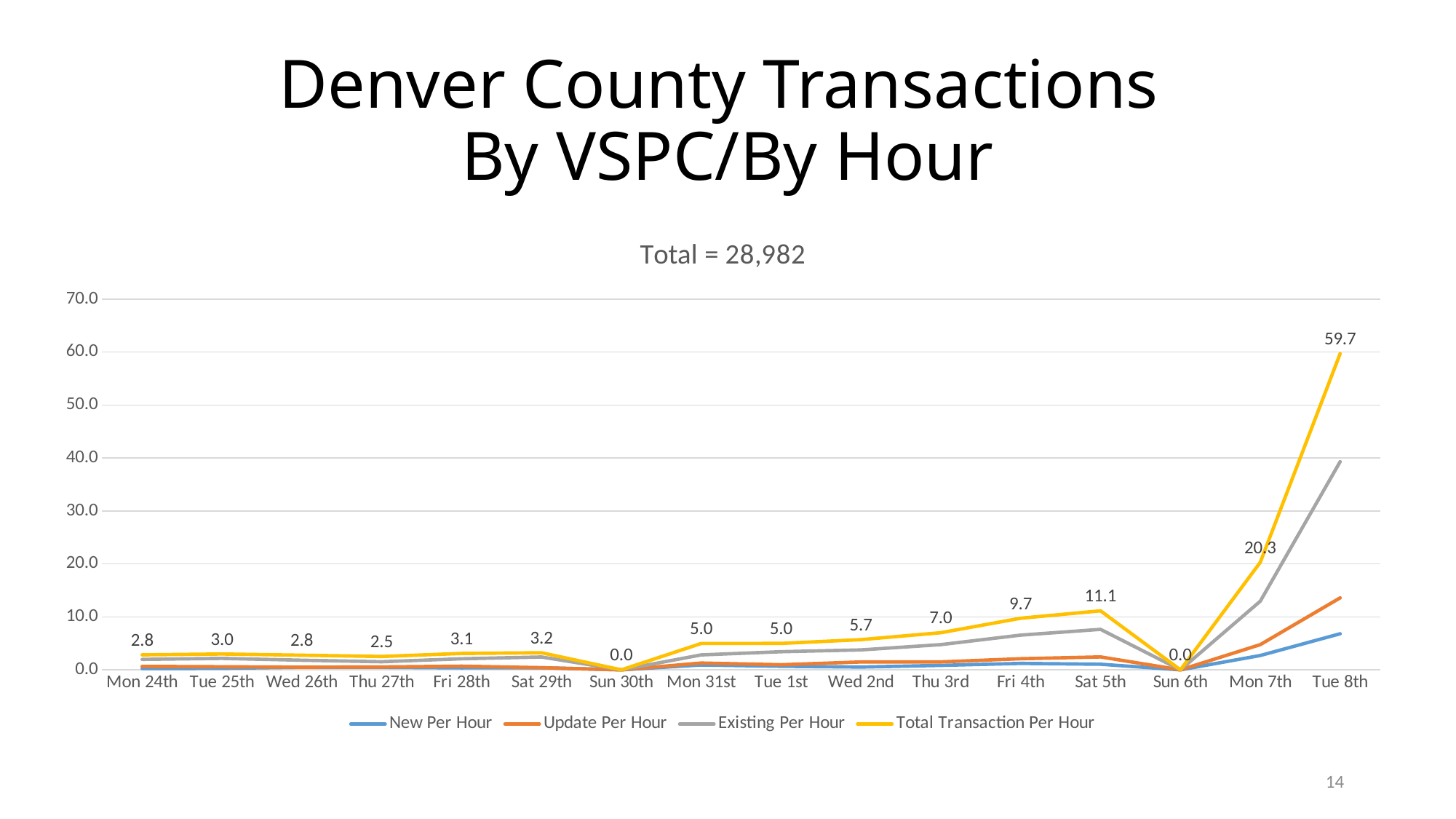
How many series does the legend list? 4 How many dates are shown along the x axis? 16 What is the Total Transaction Per Hour value for Mon 7th? 20.3 What kind of chart is shown on the slide? line chart What is the difference between the Total Transaction Per Hour values for Tue 8th and Mon 7th? 39.4 What is the Total Transaction Per Hour value for Thu 27th? 2.5 Which is larger, the Total Transaction Per Hour value for Fri 4th or for Thu 3rd? Fri 4th Is the Existing Per Hour value for Tue 8th greater or less than 30.0? greater On which date is Total Transaction Per Hour highest? Tue 8th What total is stated in the subtitle above the chart? Total = 28,982 What is the Total Transaction Per Hour value for Tue 8th? 59.7 What is the Total Transaction Per Hour value for Sat 5th? 11.1